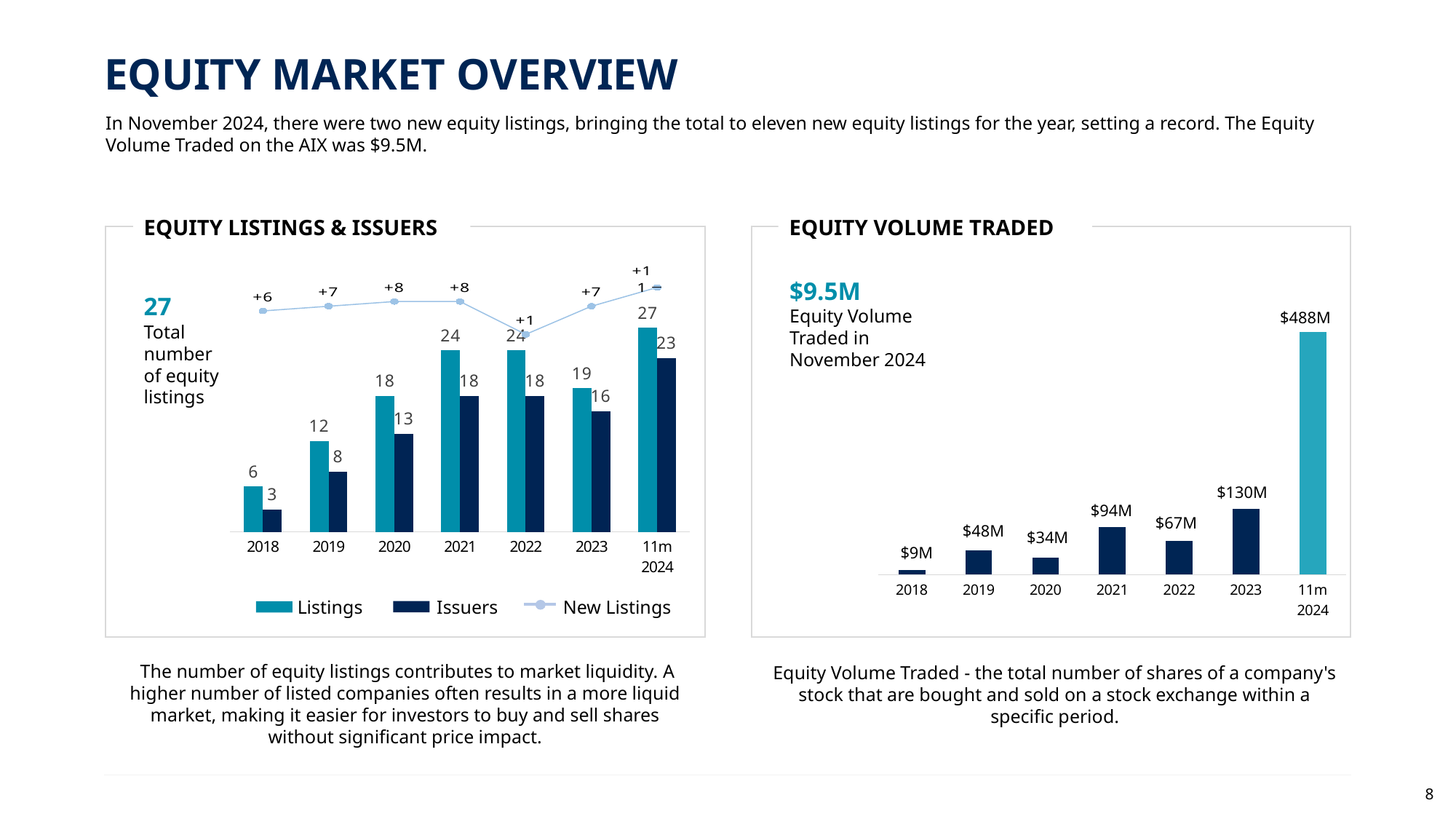
In the Equity Volume Traded chart, what is the value for 2021? $94M In the Equity Listings & Issuers chart, how many series does the legend list? 3 In the Equity Listings & Issuers chart, what is the difference between Listings and Issuers in 2020? 5 In the Equity Listings & Issuers chart, what is the New Listings value for 2022? +1 In the Equity Volume Traded chart, what is the difference between the 2023 and 2022 values? $63M In the Equity Listings & Issuers chart, what is the number of Listings in 2021? 24 In the Equity Listings & Issuers chart, which year has the lowest number of Issuers? 2018 What type of chart is the Equity Volume Traded chart? Bar chart In the Equity Listings & Issuers chart, what is the number of Issuers in 2023? 16 In the Equity Volume Traded chart, how many periods are shown on the x axis? 7 In the Equity Volume Traded chart, which period has the highest value? 11m 2024 In the Equity Listings & Issuers chart, which is larger: Listings in 2023 or Listings in 2022? Listings in 2022